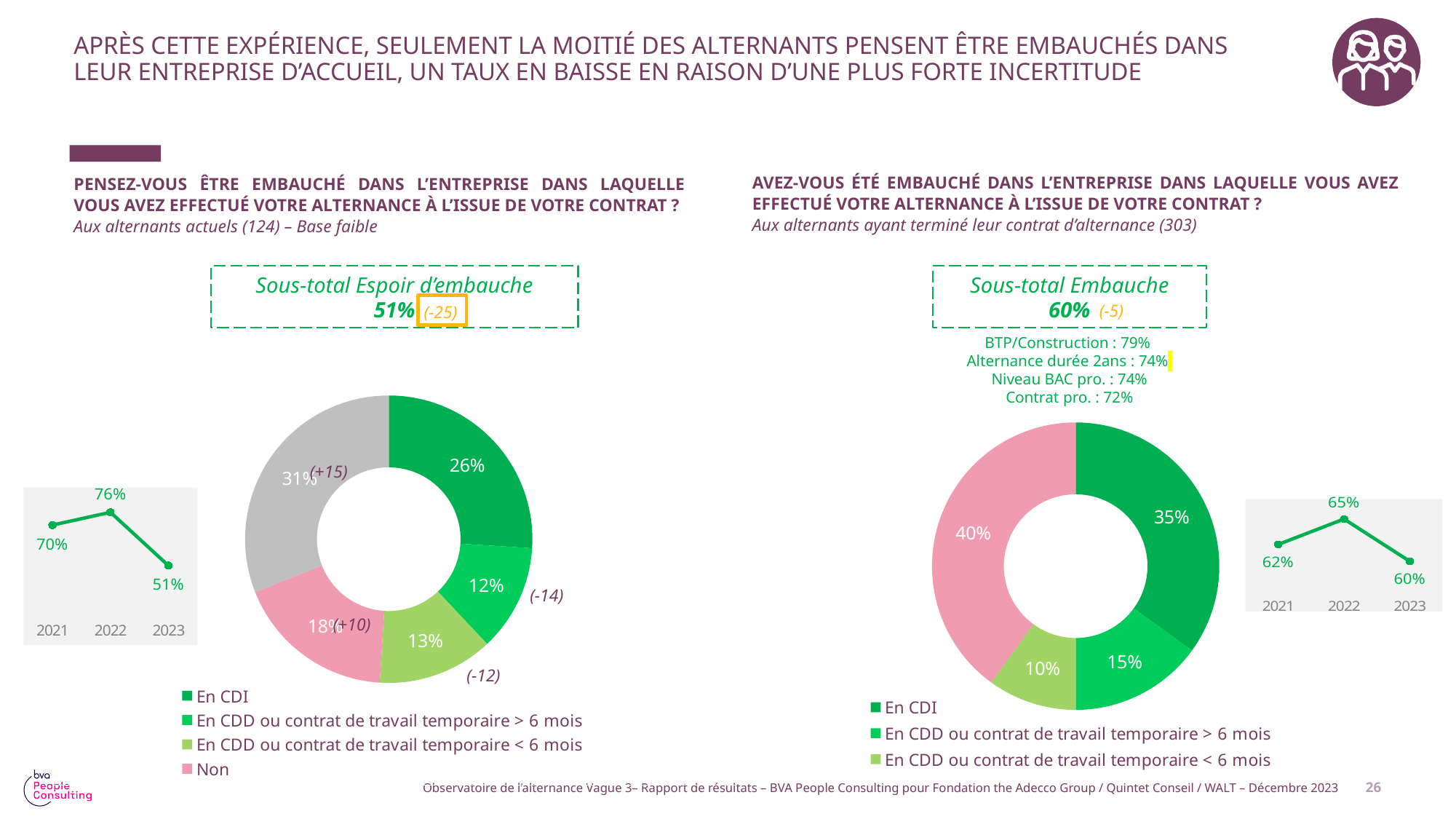
In the left donut chart, what is the value for 'En CDD ou contrat de travail temporaire < 6 mois'? 13% In the right donut chart, what is the value for 'En CDD ou contrat de travail temporaire > 6 mois'? 15% In the right line chart, is the value for 2022 larger or smaller than the value for 2023? larger In the right donut chart, what percentage answered 'En CDI'? 35% In the left donut chart, what percentage of current alternants answered 'En CDI'? 26% In the right donut chart, what is the difference between the 'En CDI' share and the 'En CDD ou contrat de travail temporaire < 6 mois' share? 25 points In the left line chart, which year has the lowest value? 2023 In the right line chart (2021–2023), what is the value for 2021? 62% In the left line chart (2021–2023), what is the value for 2022? 76% In the left donut chart, what is the value for 'Non'? 18% How many entries does the legend of the left donut chart list? 4 In the right donut chart, which labelled legend category has the lowest value? En CDD ou contrat de travail temporaire < 6 mois